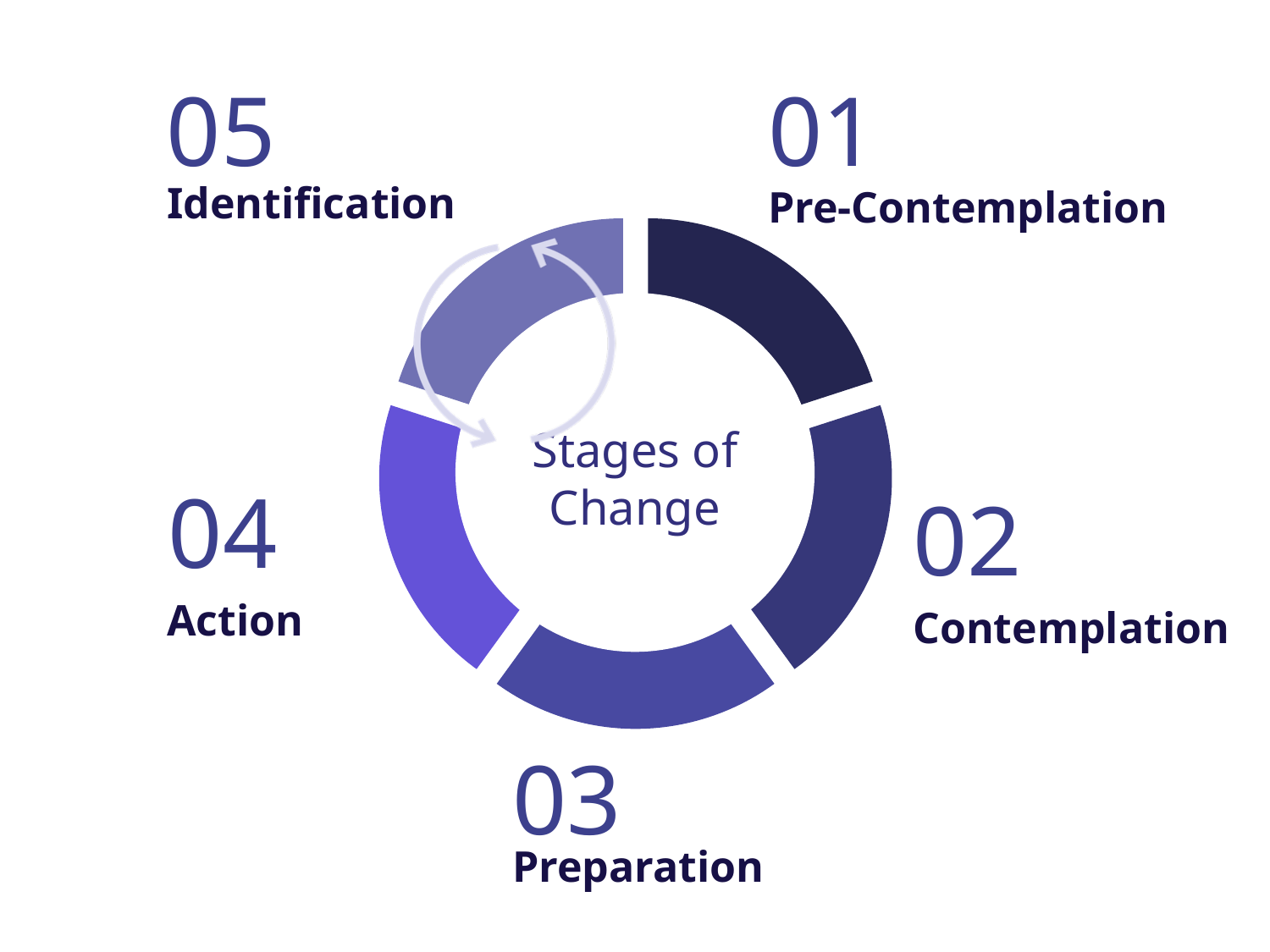
How many segments does the Stages of Change doughnut chart have? 5 What number is assigned to the Action stage? 04 Which stage is labelled 03 on the chart? Preparation Which stage is labelled 02? Contemplation What is the title shown in the centre of the doughnut chart? Stages of Change What kind of chart is shown on the slide? Doughnut chart Which segment of the doughnut chart is the darkest in colour? Pre-Contemplation Which stage is labelled 01? Pre-Contemplation What number is assigned to the Identification stage? 05